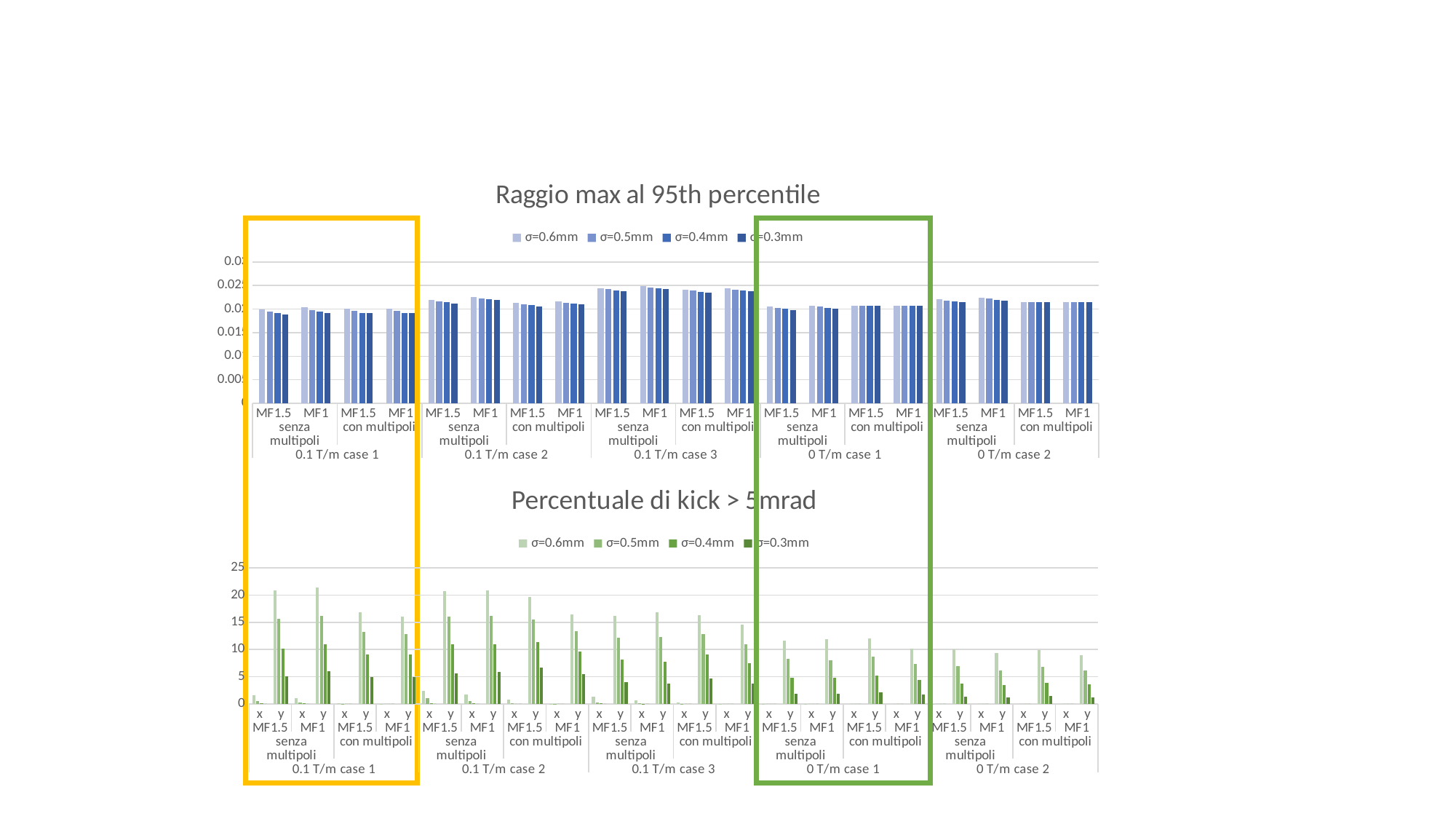
In the bottom chart 'Percentuale di kick > 5mrad', within each y group, do the bars rise or fall going from σ=0.6mm to σ=0.3mm? fall How many series does the legend of the bottom chart 'Percentuale di kick > 5mrad' list? 4 In the bottom chart 'Percentuale di kick > 5mrad', for y, MF1.5 senza multipoli, 0.1 T/m case 1, which series has the tallest bar? σ=0.6mm In the top chart 'Raggio max al 95th percentile', is the σ=0.6mm value for MF1.5 senza multipoli in 0.1 T/m case 3 greater or less than 0.02? greater In the bottom chart 'Percentuale di kick > 5mrad', is the σ=0.6mm value for x, MF1.5 senza multipoli, 0.1 T/m case 1 greater or less than 5? less What kind of chart is the top chart titled 'Raggio max al 95th percentile'? bar chart In the top chart 'Raggio max al 95th percentile', how many case groups (e.g. '0.1 T/m case 1') are shown along the x axis? 5 In the bottom chart 'Percentuale di kick > 5mrad', is the σ=0.6mm value for y, MF1.5 senza multipoli, 0 T/m case 1 greater or less than 10? greater How many series does the legend of the top chart 'Raggio max al 95th percentile' list? 4 In the top chart 'Raggio max al 95th percentile', which case group has the tallest bars? 0.1 T/m case 3 What is the title of the bottom chart on the slide? Percentuale di kick > 5mrad In the top chart 'Raggio max al 95th percentile', is the σ=0.6mm value for MF1.5 senza multipoli larger in 0.1 T/m case 3 or in 0.1 T/m case 1? 0.1 T/m case 3